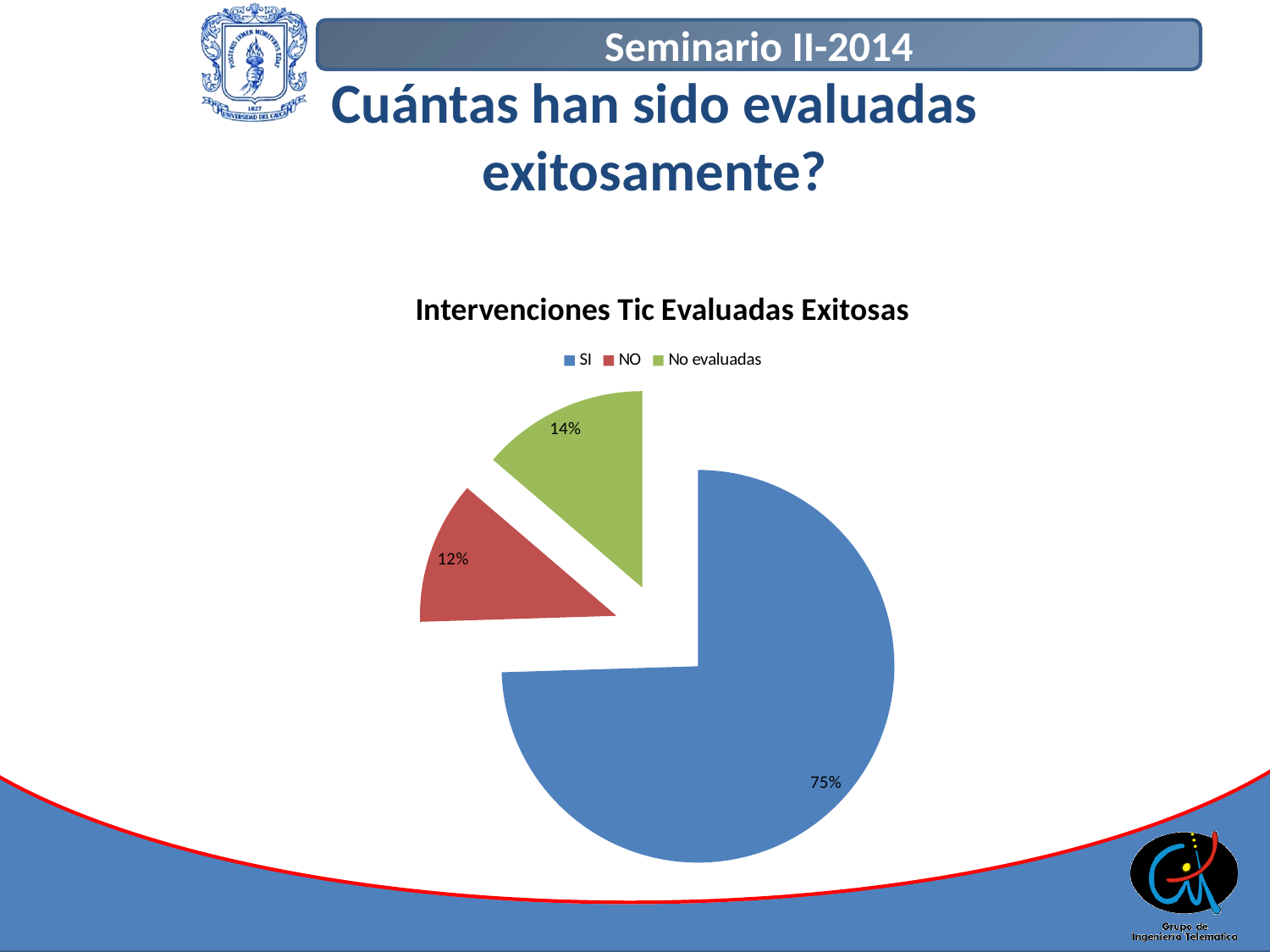
Which is larger, the SI slice or the NO slice? SI What share of the pie is the NO slice? 12% What is the difference in percentage points between the SI slice and the No evaluadas slice? 61 What kind of chart is shown on the slide? pie chart What share of the pie is the SI slice? 75% What share of the pie is the No evaluadas slice? 14% Which category has the largest slice? SI What is the chart's title? Intervenciones Tic Evaluadas Exitosas Which category has the smallest slice? NO How many slices does the pie chart have? 3 How many entries does the legend list? 3 What colour is the SI slice? blue